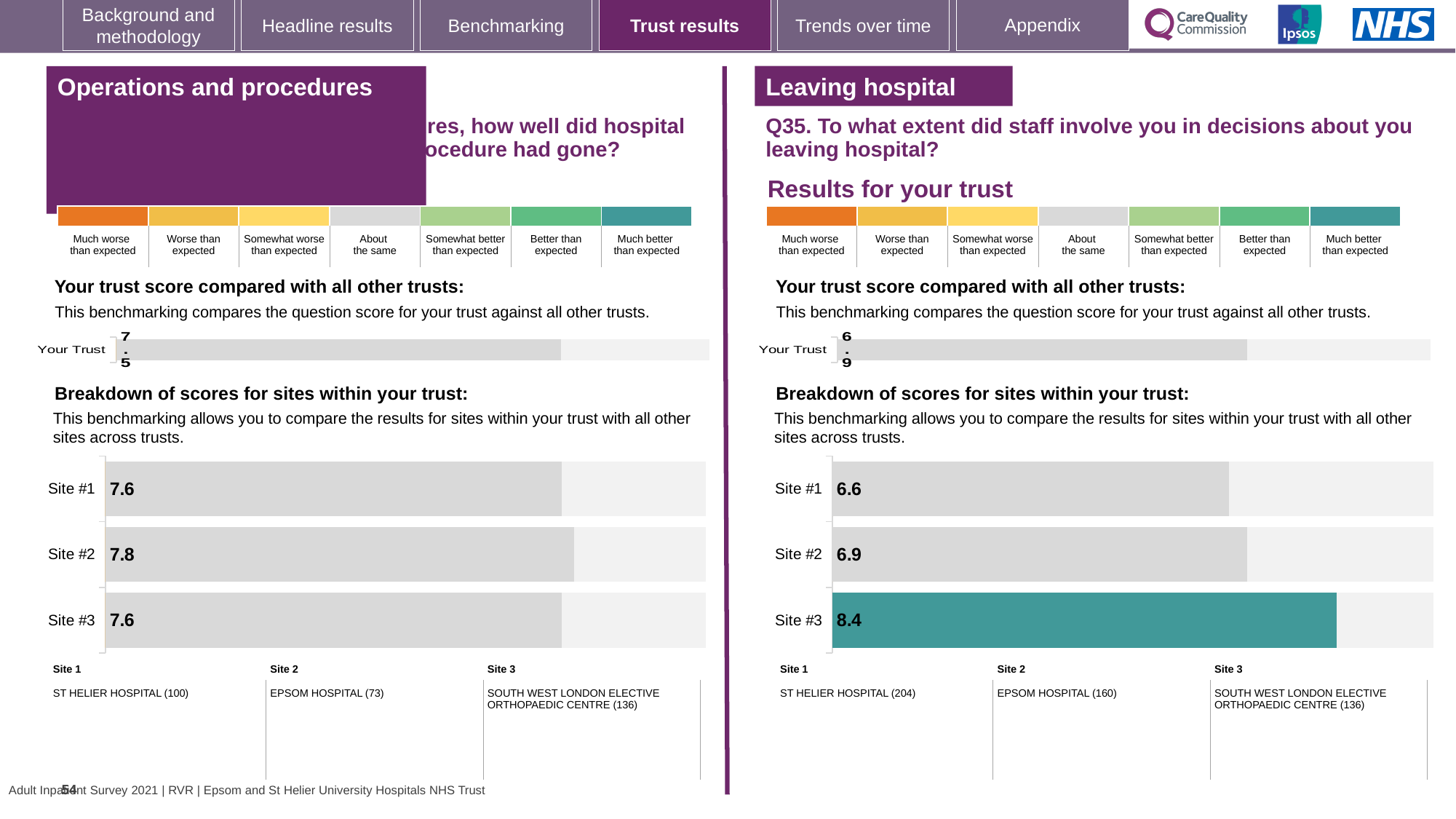
In the 'Leaving hospital' section on the right, what is the 'Your Trust' score shown in the trust comparison chart? 6.9 In the 'Leaving hospital' site breakdown chart on the right, which site has the highest score? Site #3 What type of chart is used for the site breakdown in the 'Leaving hospital' section on the right? Bar chart In the 'Leaving hospital' site breakdown chart on the right, what is the score for Site #1? 6.6 In the 'Leaving hospital' site breakdown chart on the right, what is the difference between the scores for Site #3 and Site #1? 1.8 In the 'Leaving hospital' site breakdown chart on the right, what is the score for Site #3? 8.4 In the 'Leaving hospital' site breakdown chart on the right, which site has the lowest score? Site #1 In the 'Operations and procedures' site breakdown chart on the left, what is the difference between the scores for Site #2 and Site #1? 0.2 In the 'Operations and procedures' site breakdown chart on the left, what is the score for Site #2? 7.8 How many sites are shown in the 'Leaving hospital' site breakdown chart on the right? 3 In the 'Operations and procedures' section on the left, what is the 'Your Trust' score shown in the trust comparison chart? 7.5 In the 'Operations and procedures' site breakdown chart on the left, which site has the highest score? Site #2